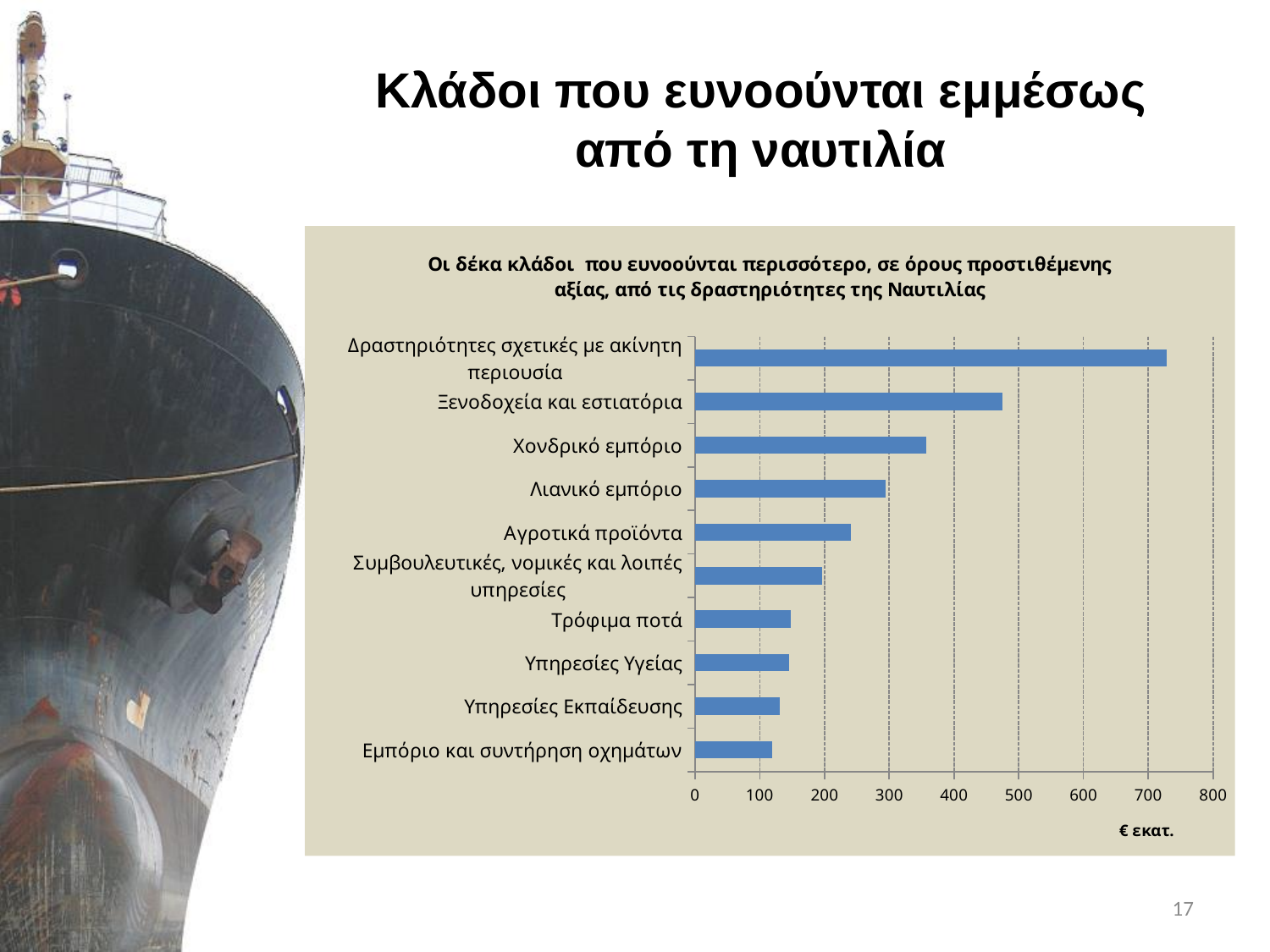
Which is larger, the value for Ξενοδοχεία και εστιατόρια or the value for Χονδρικό εμπόριο? Ξενοδοχεία και εστιατόρια Is the value for Εμπόριο και συντήρηση οχημάτων greater or less than 200? less How many sectors (categories) are plotted in the chart? 10 What is the highest value shown on the horizontal axis of the chart? 800 Is the value for Χονδρικό εμπόριο greater or less than 300? greater What kind of chart is shown on the slide? bar chart Is the value for Ξενοδοχεία και εστιατόρια greater or less than 500? less Which is larger, the value for Λιανικό εμπόριο or the value for Υπηρεσίες Υγείας? Λιανικό εμπόριο What unit is shown below the horizontal axis of the chart? € εκατ. Which sector has the highest value in the chart? Δραστηριότητες σχετικές με ακίνητη περιουσία